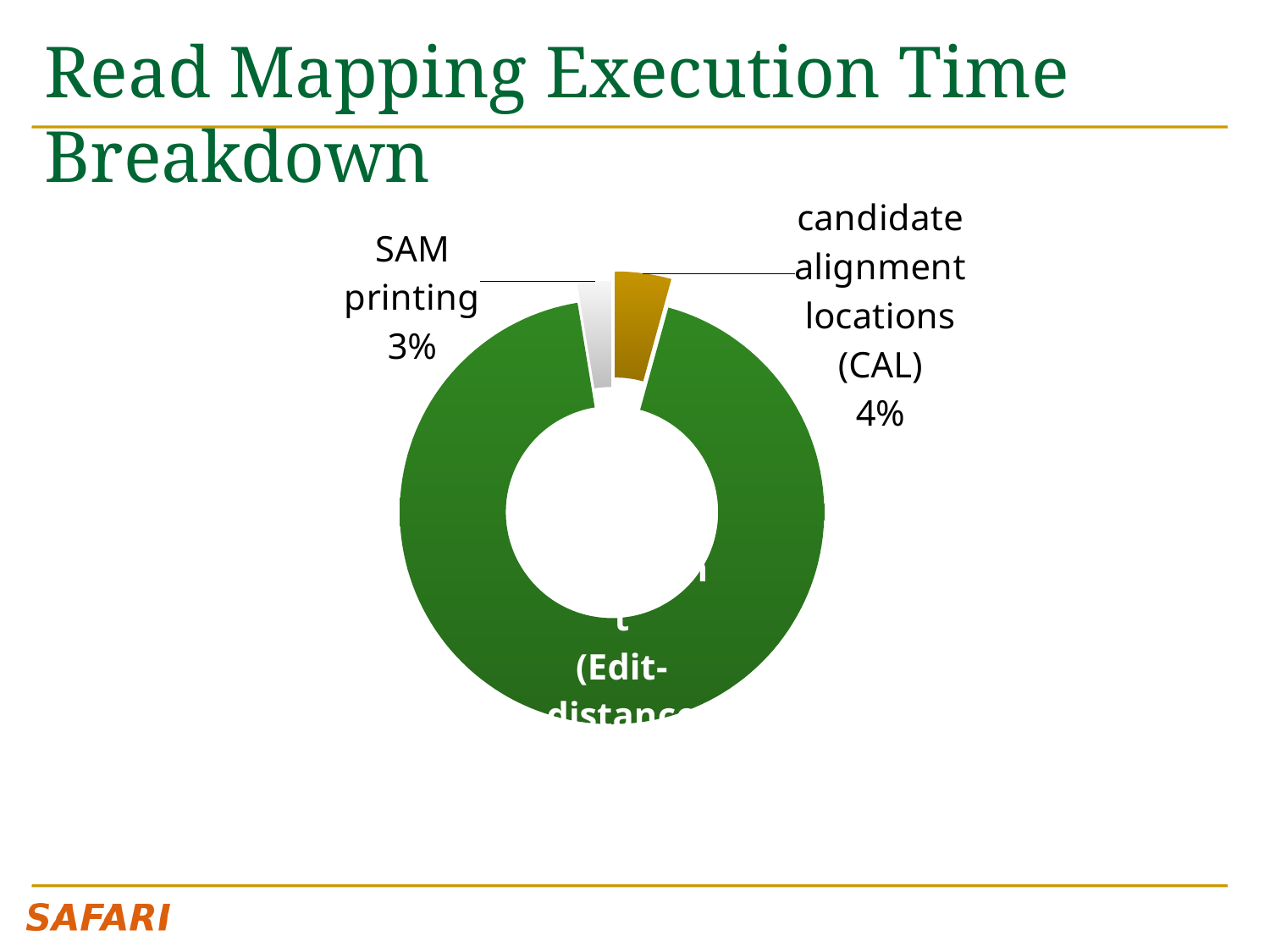
What is the title of the slide containing the chart? Read Mapping Execution Time Breakdown What kind of chart is shown on the slide? doughnut chart What colour is the slice representing candidate alignment locations (CAL)? gold How many slices does the chart contain? 3 By how many percentage points does the CAL share exceed the SAM printing share? 1% Which labelled category has the smallest share of execution time? SAM printing Which takes a larger share of execution time, SAM printing or candidate alignment locations (CAL)? candidate alignment locations (CAL) What percentage of execution time is attributed to candidate alignment locations (CAL)? 4% What percentage of read mapping execution time is spent on SAM printing? 3%